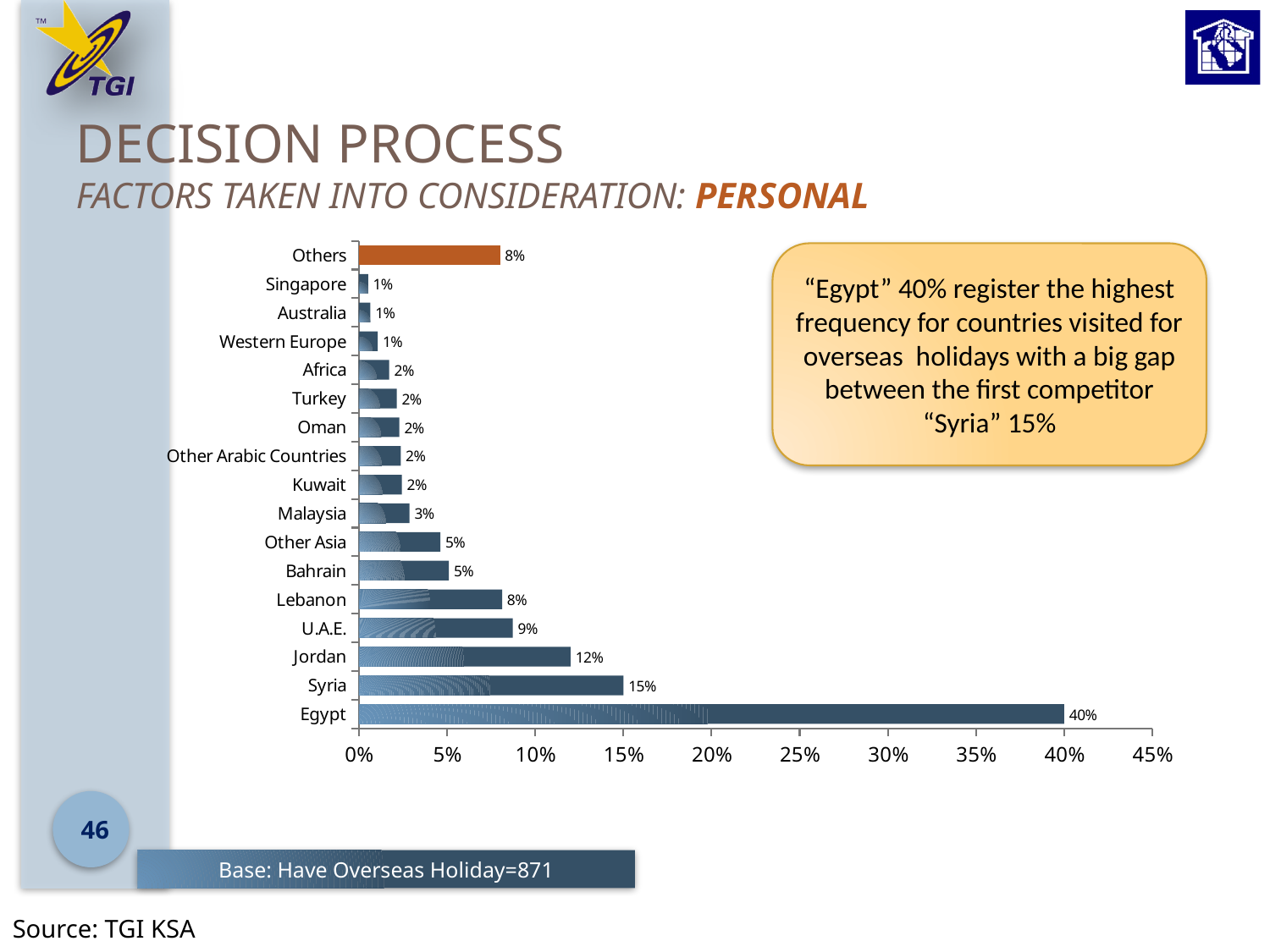
How many categories are shown in the chart? 17 Which is larger, the value for Bahrain or the value for Lebanon? Lebanon What percentage is shown for Egypt? 40% What is the value for U.A.E.? 9% What is the difference between the values for Jordan and Lebanon? 4% Is the value for Egypt greater or less than 35%? greater What percentage is shown for Jordan? 12% What is the difference between the values for Egypt and Syria? 25% What is the value for Syria? 15% What kind of chart is shown on the slide? Bar chart Which country has the highest value in the chart? Egypt What percentage is shown for Malaysia? 3%